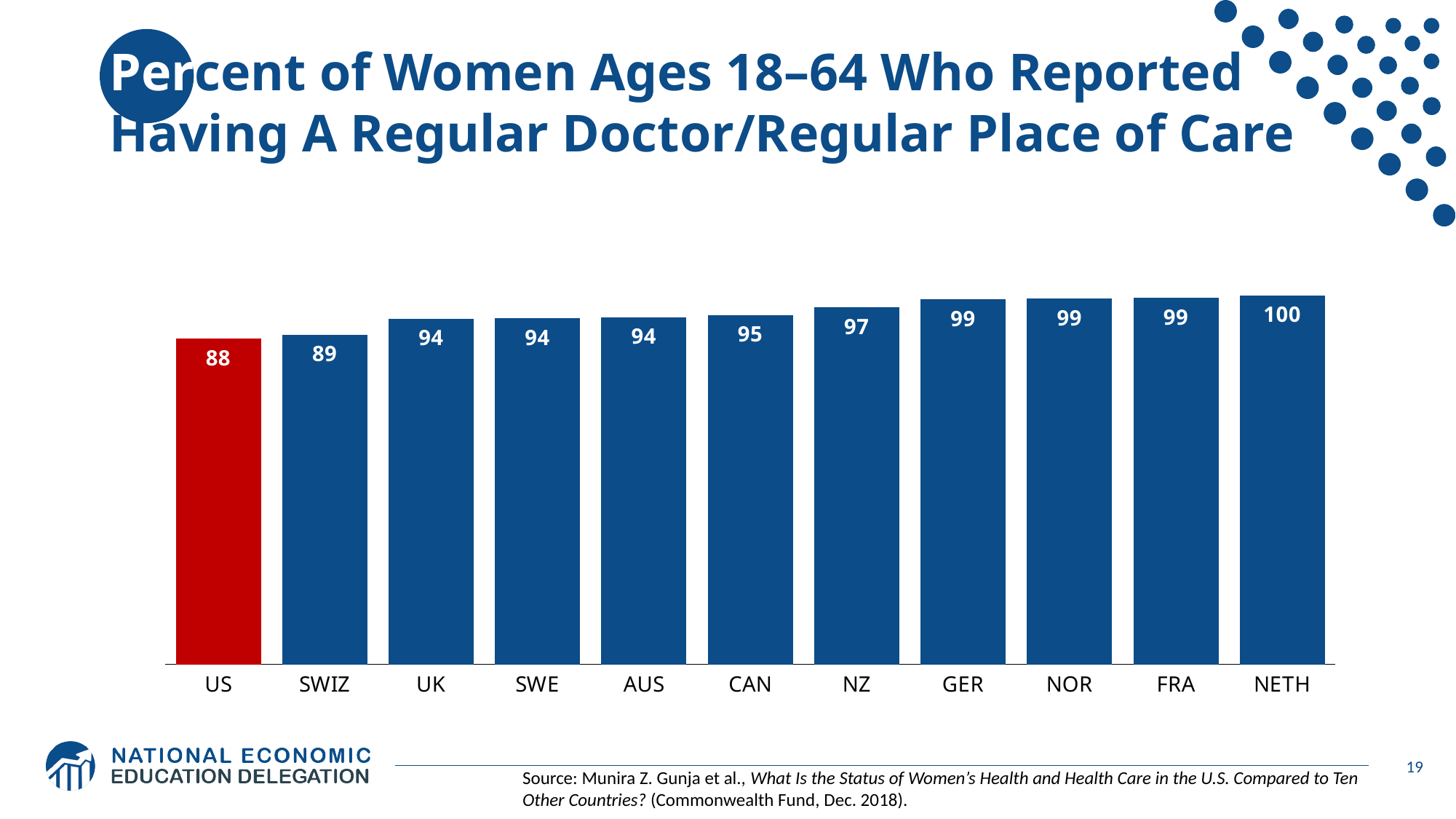
Which country has the highest value? NETH What kind of chart is shown on the slide? Bar chart What is the difference between the values for NETH and the US? 12 Do the values rise or fall moving from left to right along the x axis? Rise Which bar is coloured red rather than blue? US What is the value for CAN? 95 Which has a larger value, CAN or SWIZ? CAN What is the value for the US? 88 How many countries are shown in the chart? 11 What is the difference between the values for SWIZ and UK? 5 What is the value for NZ? 97 Which country has the lowest value? US